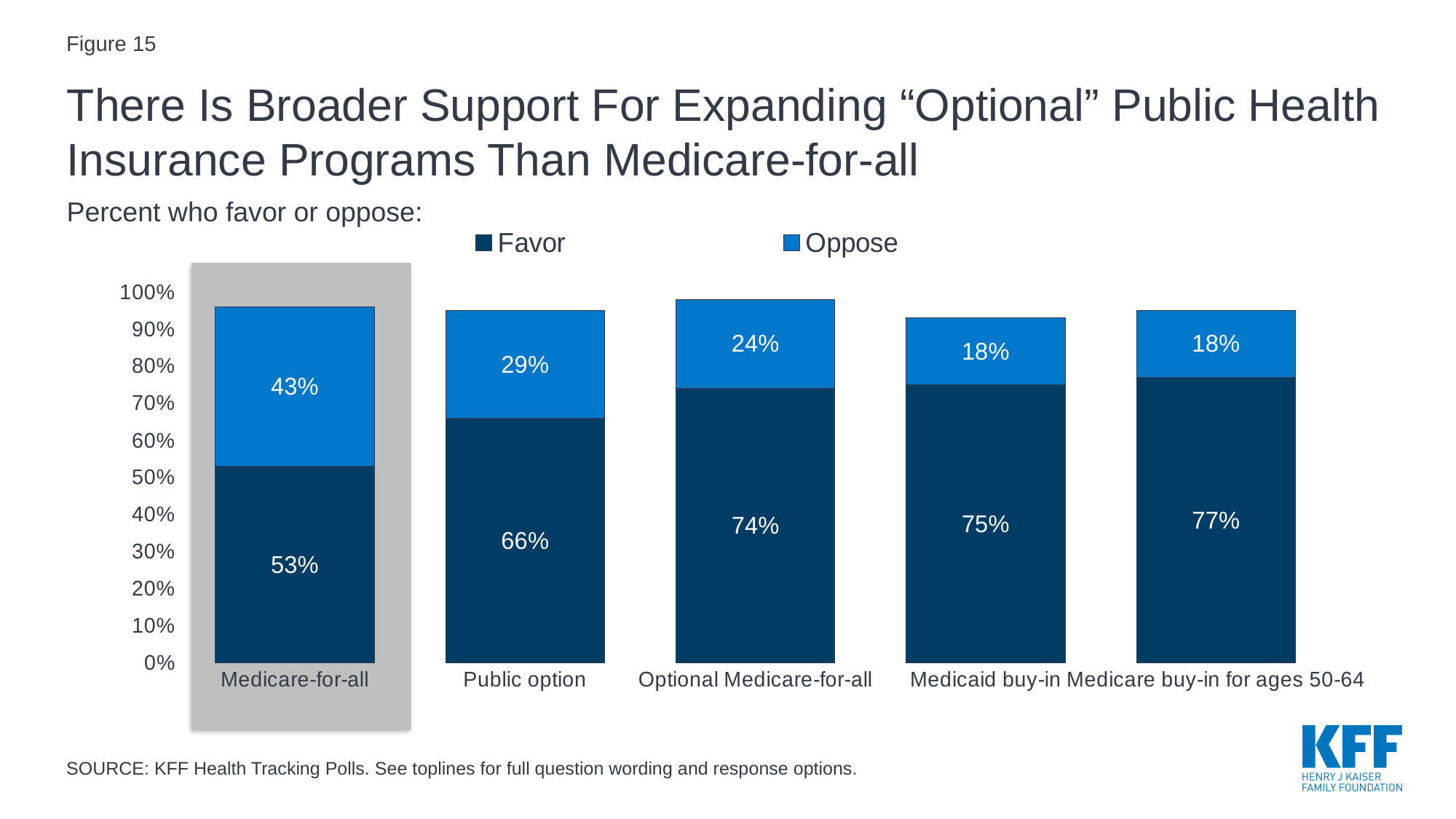
What is the combined favor and oppose total for the Medicaid buy-in bar? 93% What percent favor Medicare buy-in for ages 50-64? 77% How many proposals are shown on the x axis? 5 What is the difference between the percent who favor Medicare buy-in for ages 50-64 and the percent who favor Medicare-for-all? 24 percentage points Is the percent who oppose Optional Medicare-for-all larger or smaller than the percent who oppose the public option? smaller What kind of chart is shown? Stacked bar chart What percent oppose the public option? 29% Which proposal has the highest percent who favor it? Medicare buy-in for ages 50-64 Which proposal has the lowest percent who favor it? Medicare-for-all What percent favor Medicare-for-all? 53% Which proposal has the highest percent who oppose it? Medicare-for-all How many series does the legend list? 2